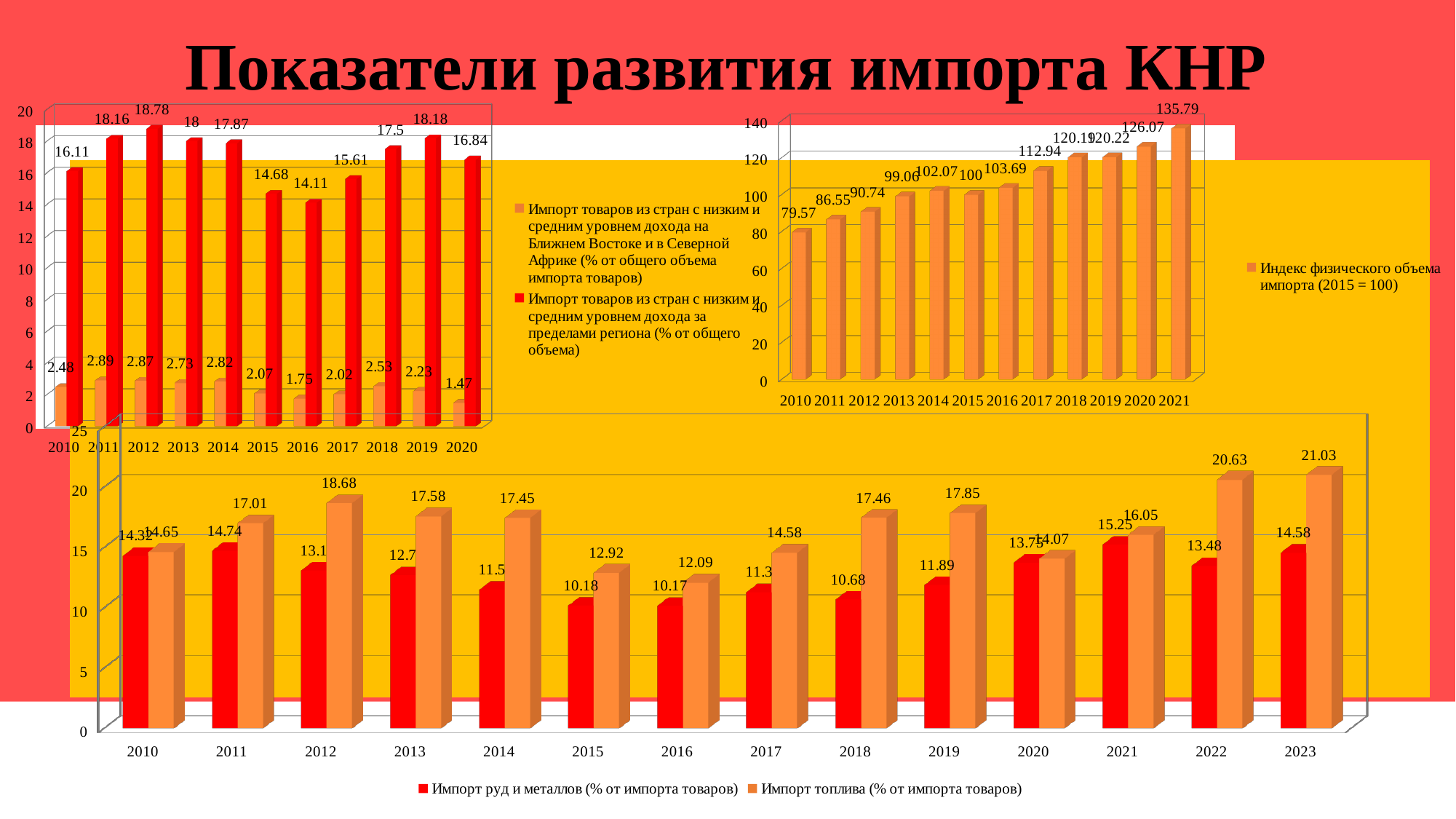
In the bottom chart, which is larger in 2012: fuel imports or ores and metals imports? Импорт топлива (% от импорта товаров) In the bottom chart, what is the value of 'Импорт руд и металлов (% от импорта товаров)' for 2015? 10.18 In the top-left chart, what is the 2012 value for imports from low- and middle-income countries outside the region (red series)? 18.78 In the bottom chart, which year has the highest value for 'Импорт топлива (% от импорта товаров)'? 2023 In the bottom chart, what is the value of 'Импорт топлива (% от импорта товаров)' for 2023? 21.03 In the top-right chart, do the values generally rise or fall from 2010 to 2021? rise What kind of chart is the top-left chart? bar chart In the bottom chart, what is the difference between fuel imports and ores and metals imports in 2023? 6.45 How many years are shown on the x axis of the top-right chart? 12 How many series does the legend of the bottom chart list? 2 In the top-right chart, which year has the lowest value of the import physical volume index? 2010 In the top-right chart, what is the value of the import physical volume index for 2021? 135.79